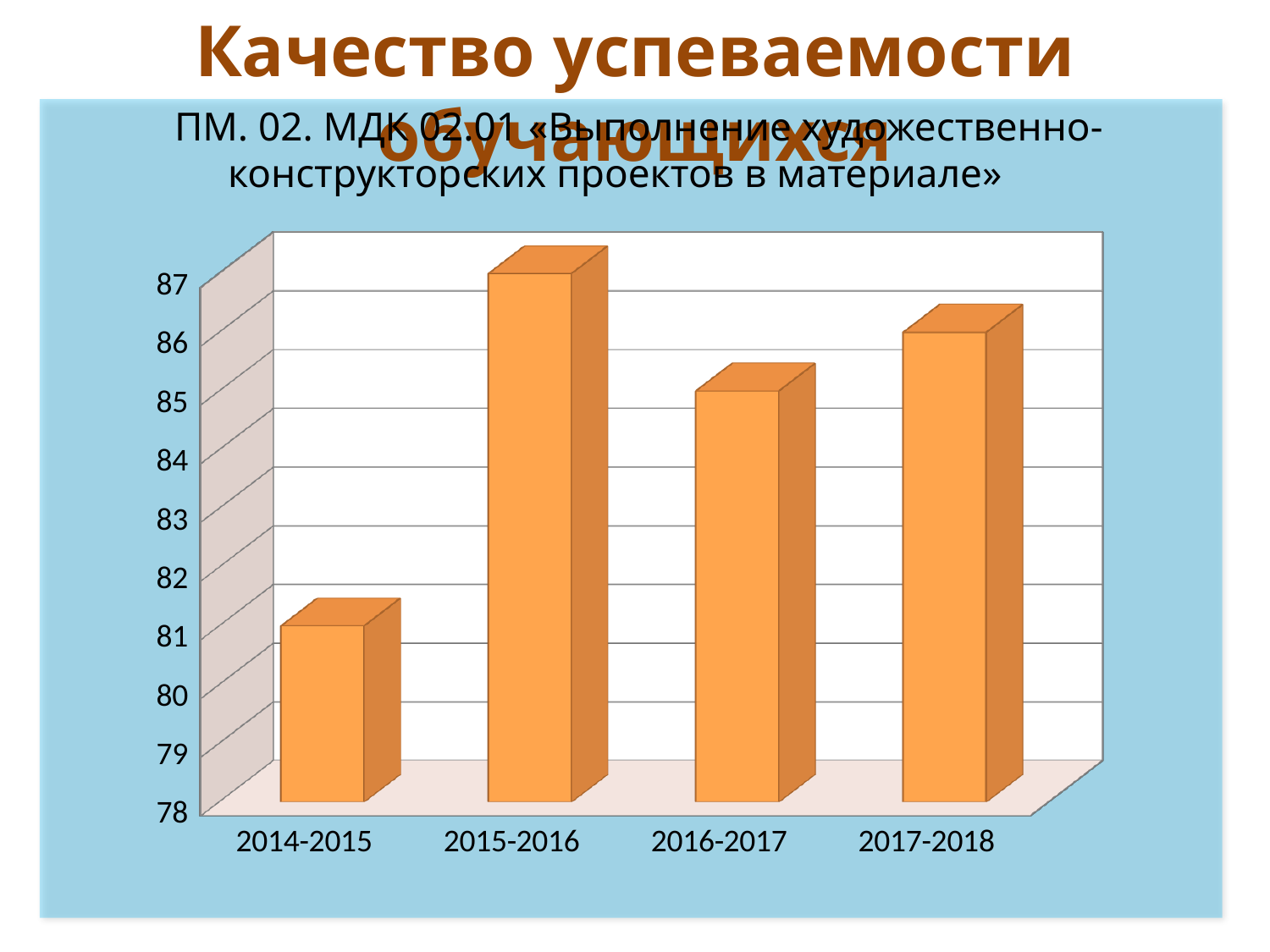
Which is larger, the value for 2014-2015 or the value for 2016-2017? 2016-2017 Does the value rise or fall from 2015-2016 to 2016-2017? fall Is the value for 2016-2017 greater or less than 84? greater How many academic years are shown on the x axis of the chart? 4 What kind of chart is shown on the slide? bar chart What is the title of the chart? ПМ. 02. МДК 02.01 «Выполнение художественно-конструкторских проектов в материале» Is the value for 2017-2018 greater or less than 85? greater Which academic year has the lowest bar in the chart? 2014-2015 Is the value for 2015-2016 greater or less than 86? greater Which academic year has the highest bar in the chart? 2015-2016 Which is larger, the value for 2015-2016 or the value for 2017-2018? 2015-2016